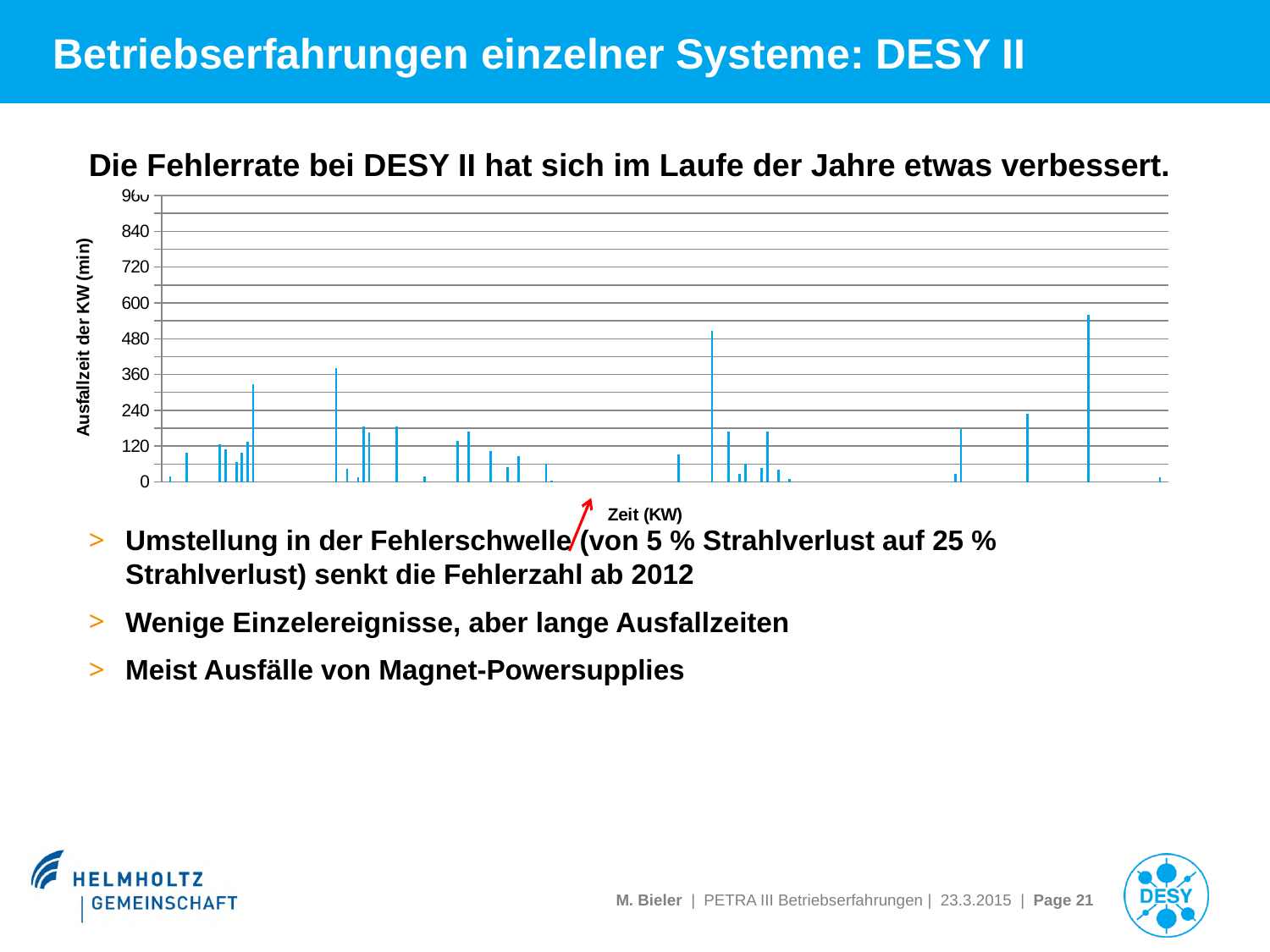
Is the value of the tallest bar in the chart greater or less than 600? less What is the label of the x axis of the chart? Zeit (KW) What kind of chart is shown on the slide? bar chart What is the highest value shown on the y axis of the chart? 960 Is the value of the second-tallest bar, located near the middle of the chart, greater or less than 480? greater Is the value of the second-tallest bar, located near the middle of the chart, greater or less than 600? less What is the label of the y axis of the chart? Ausfallzeit der KW (min) What is the interval between consecutive tick marks on the y axis of the chart? 120